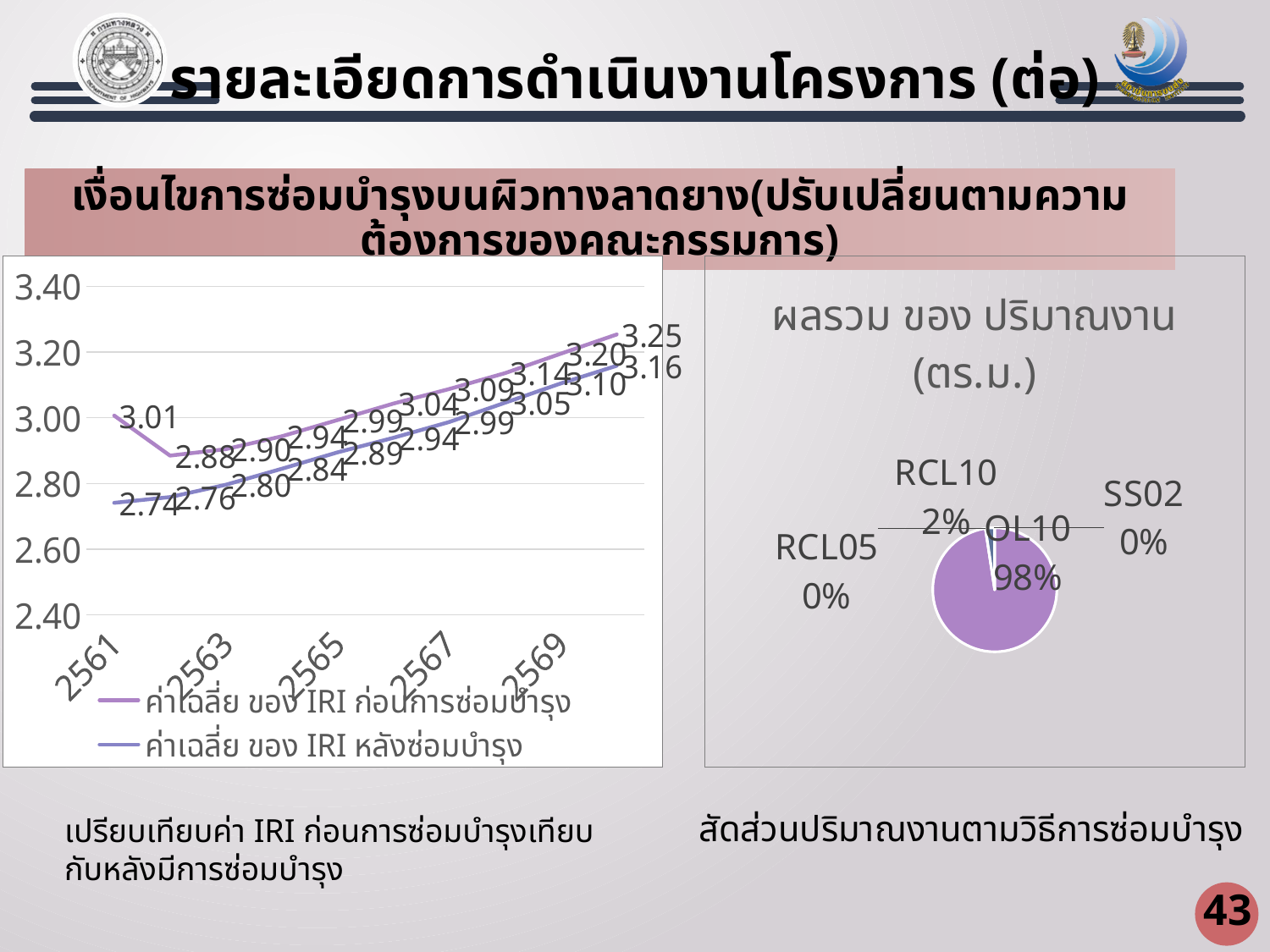
In the line chart on the left, what is the difference between the two series at 2561? 0.27 In the pie chart ผลรวม ของ ปริมาณงาน (ตร.ม.), what share does OL10 have? 98% In the pie chart ผลรวม ของ ปริมาณงาน (ตร.ม.), which category has the largest slice? OL10 In the line chart on the left, which series has the higher value at 2561? ค่าเฉลี่ย ของ IRI ก่อนการซ่อมบำรุง In the line chart on the left, how many series does the legend list? 2 In the line chart on the left, what is the value of ค่าเฉลี่ย ของ IRI หลังซ่อมบำรุง at 2561? 2.74 How many categories are shown in the pie chart ผลรวม ของ ปริมาณงาน (ตร.ม.)? 4 What kind of chart is the chart on the left of the slide? line chart What kind of chart is the chart titled ผลรวม ของ ปริมาณงาน (ตร.ม.)? pie chart In the line chart on the left, does ค่าเฉลี่ย ของ IRI หลังซ่อมบำรุง rise or fall from 2561 to the last point? rise In the pie chart ผลรวม ของ ปริมาณงาน (ตร.ม.), what share does RCL10 have? 2% In the line chart on the left, what is the value of ค่าเฉลี่ย ของ IRI ก่อนการซ่อมบำรุง at 2561? 3.01